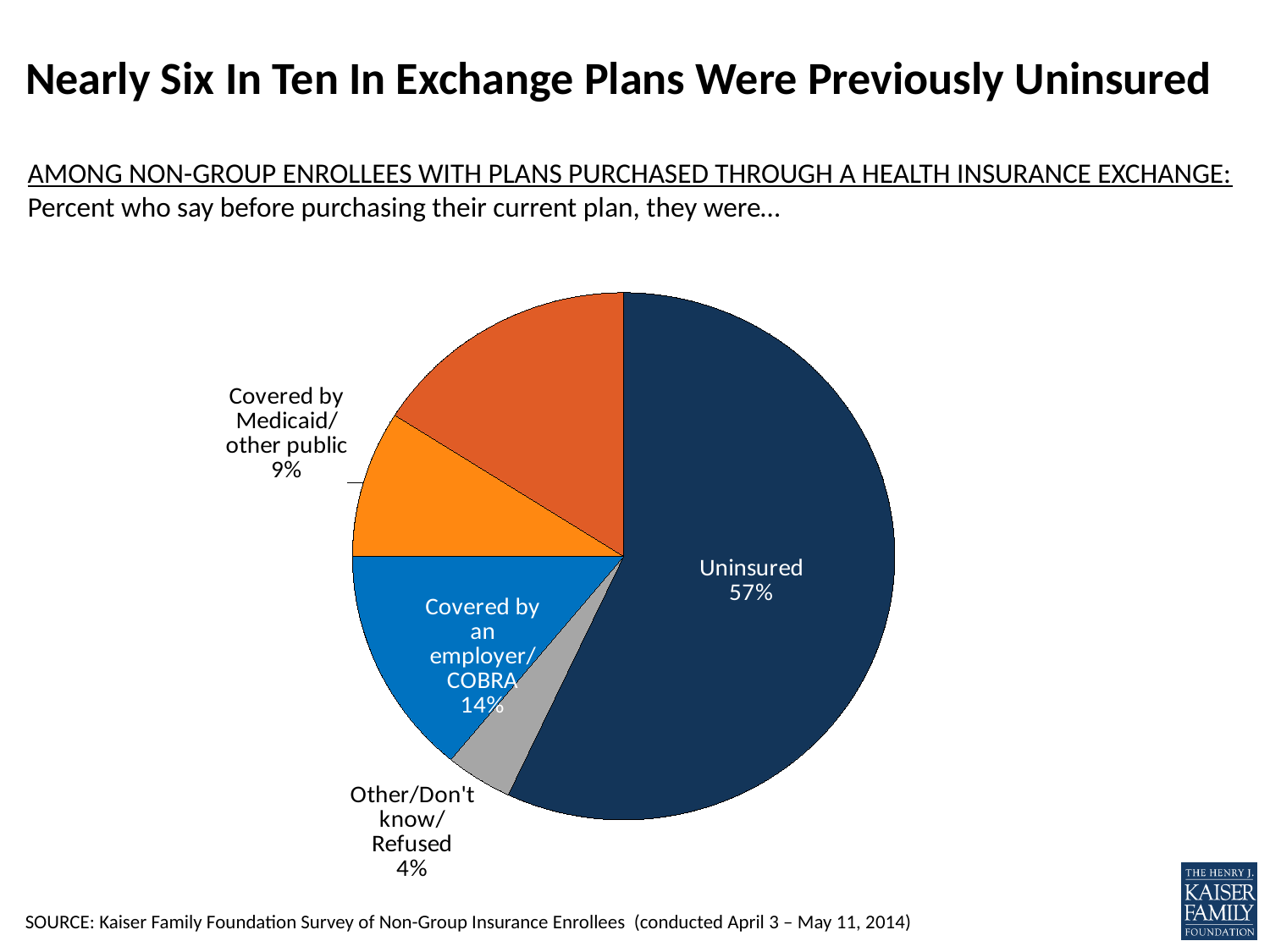
What percent were covered by an employer/COBRA before purchasing their current plan? 14% What is the title of the slide? Nearly Six In Ten In Exchange Plans Were Previously Uninsured What percent were covered by Medicaid/other public coverage before purchasing their current plan? 9% Which is larger: the share covered by an employer/COBRA or the share covered by Medicaid/other public? Covered by an employer/COBRA Which labeled category has the largest share of the pie? Uninsured Which labeled category has the smallest share of the pie? Other/Don't know/Refused What percent of exchange enrollees say they were uninsured before purchasing their current plan? 57% How many slices does the pie chart have? 5 What kind of chart is shown on the slide? Pie chart What percent fall into the Other/Don't know/Refused category? 4% What is the difference in percentage points between the Covered by Medicaid/other public share and the Other/Don't know/Refused share? 5 How many percentage points larger is the Uninsured share than the Covered by an employer/COBRA share? 43